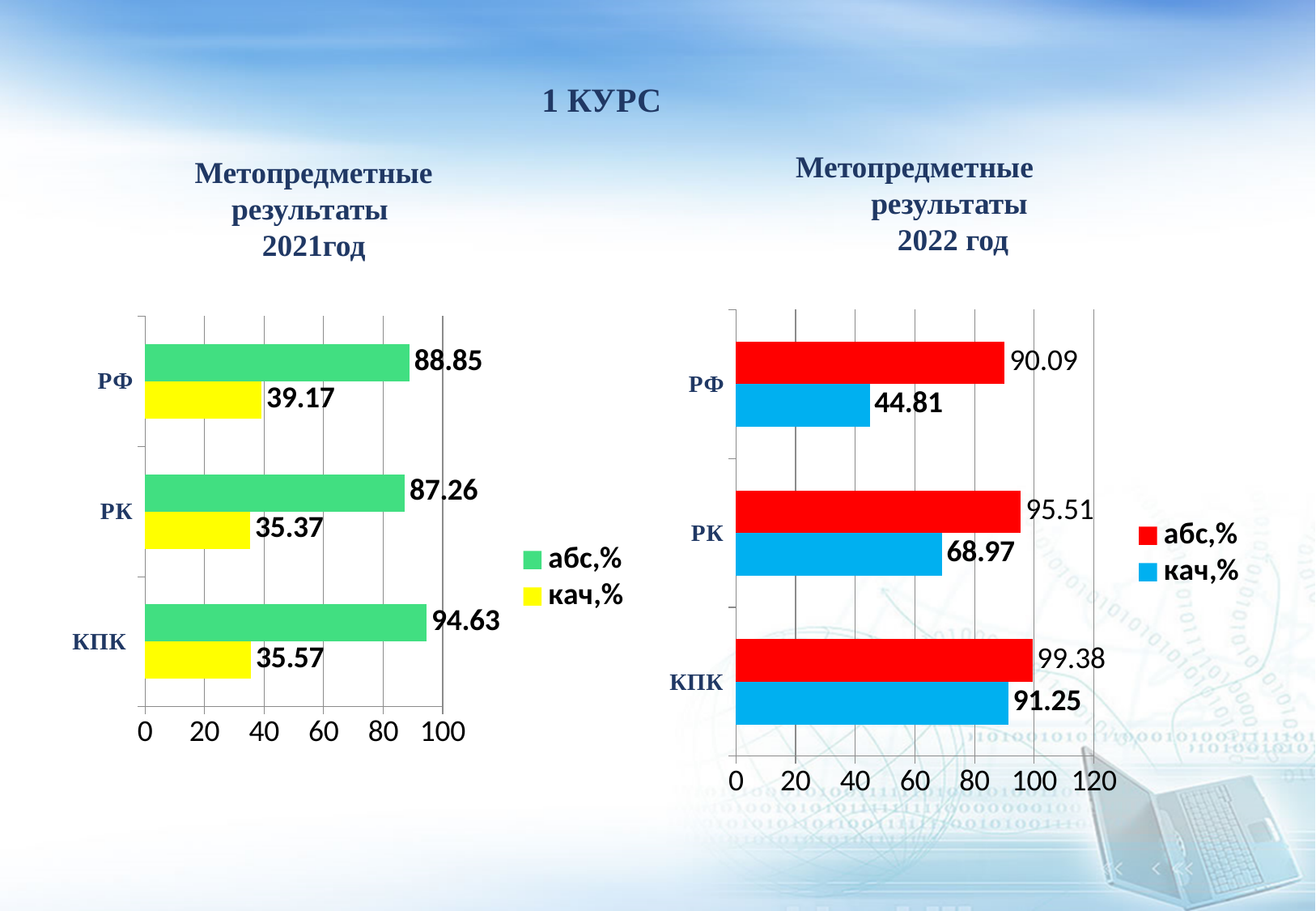
What colour represents the кач,% series in the 2022 chart (right)? Blue In the 2022 chart (right), what is the абс,% value for РФ? 90.09 In the 2022 chart (right), which category has the highest кач,% value? КПК In the 2021 chart (left), which category has the lowest абс,% value? РК In the 2021 chart (left), what is the кач,% value for РФ? 39.17 What type of chart is the 2022 chart (right)? Bar chart How many categories are shown in the 2022 chart (right)? 3 In the 2021 chart (left), which is larger: the кач,% value for РК or the кач,% value for КПК? КПК (35.57) In the 2022 chart (right), what is the кач,% value for РК? 68.97 In the 2021 chart (left), what is the абс,% value for КПК? 94.63 In the 2022 chart (right), what is the difference between the абс,% and кач,% values for КПК? 8.13 How many series does the legend of the 2021 chart (left) list? 2